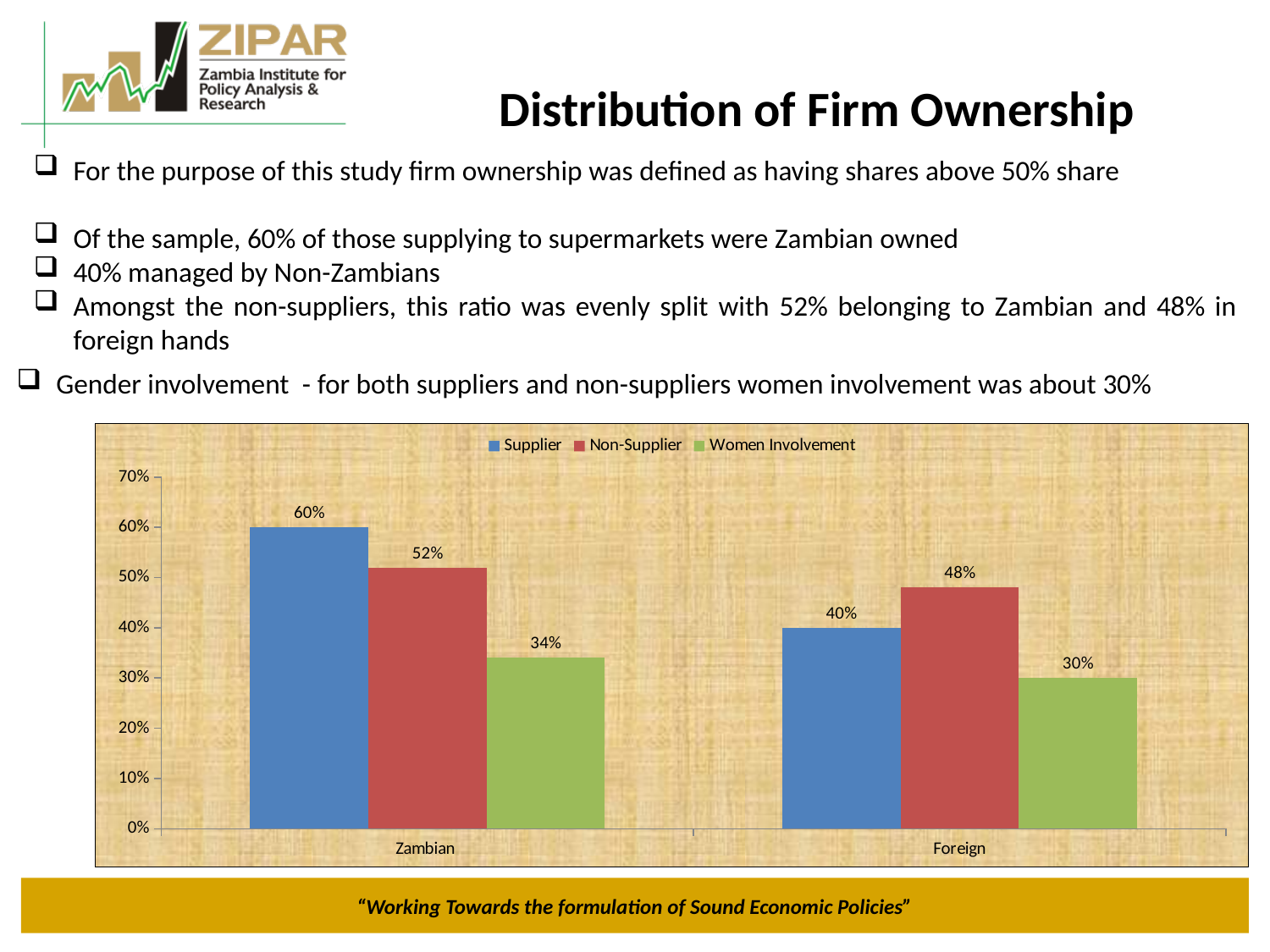
Which category has the higher Non-Supplier value? Zambian What kind of chart is shown on the slide? Bar chart What is the Supplier value for Zambian? 60% What colour are the Non-Supplier bars? Red Which series has the lowest value for Foreign? Women Involvement What is the Women Involvement value for Zambian? 34% Which is larger for Foreign: Supplier or Non-Supplier? Non-Supplier How many categories are shown on the x axis? 2 How many series does the legend list? 3 What is the Non-Supplier value for Foreign? 48% What is the difference between the Supplier values for Zambian and Foreign? 20% What is the Supplier value for Foreign? 40%